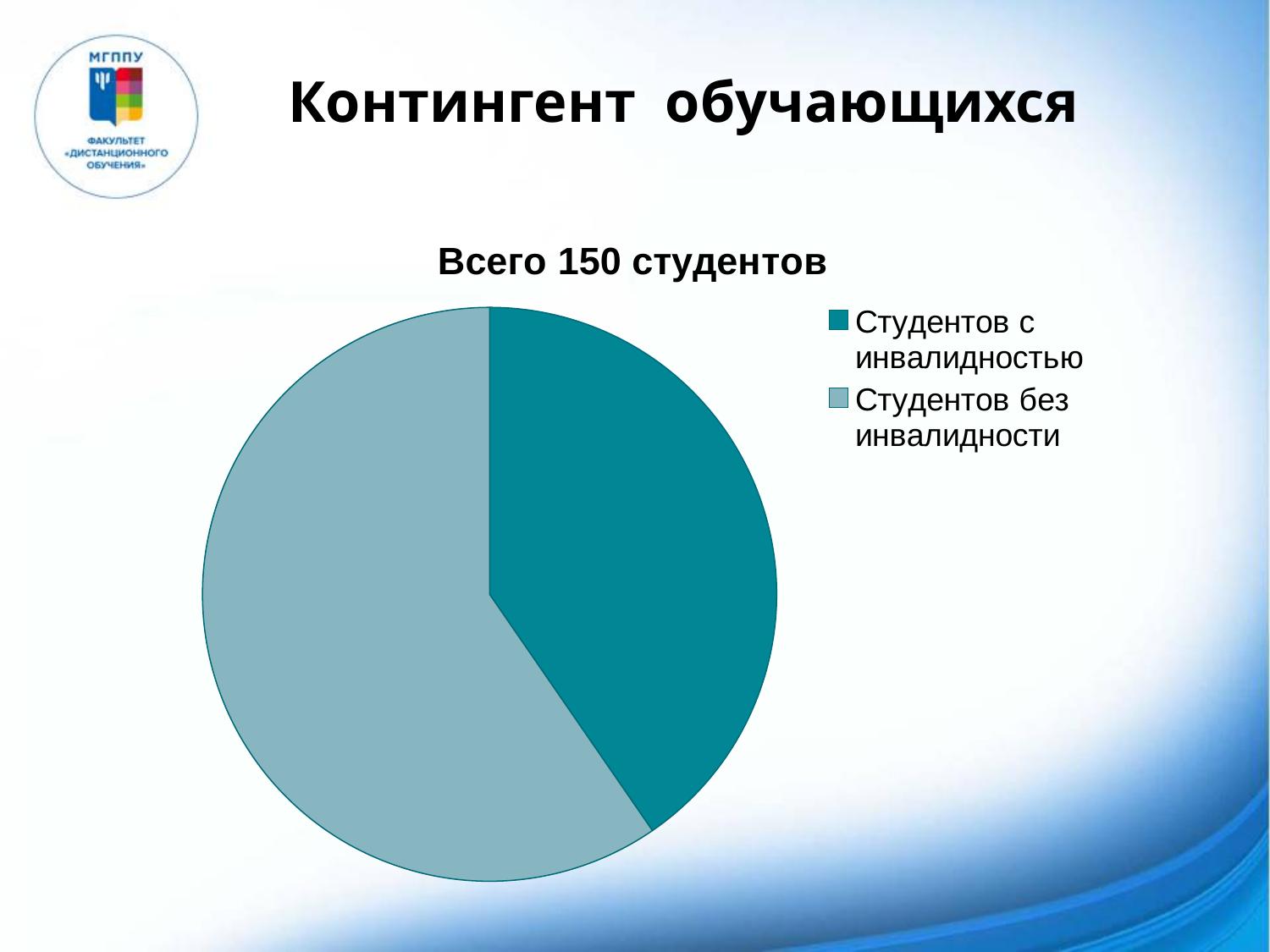
What kind of chart is shown on the slide? Pie chart How many slices does the pie chart have? 2 According to the chart title, how many students are there in total? 150 How many entries does the legend of the pie chart list? 2 Which category has the largest slice of the pie chart? Студентов без инвалидности Which legend entry is shown in the darker teal colour? Студентов с инвалидностью Which slice is larger: Студентов с инвалидностью or Студентов без инвалидности? Студентов без инвалидности What is the title of the pie chart? Всего 150 студентов Which category has the smallest slice of the pie chart? Студентов с инвалидностью